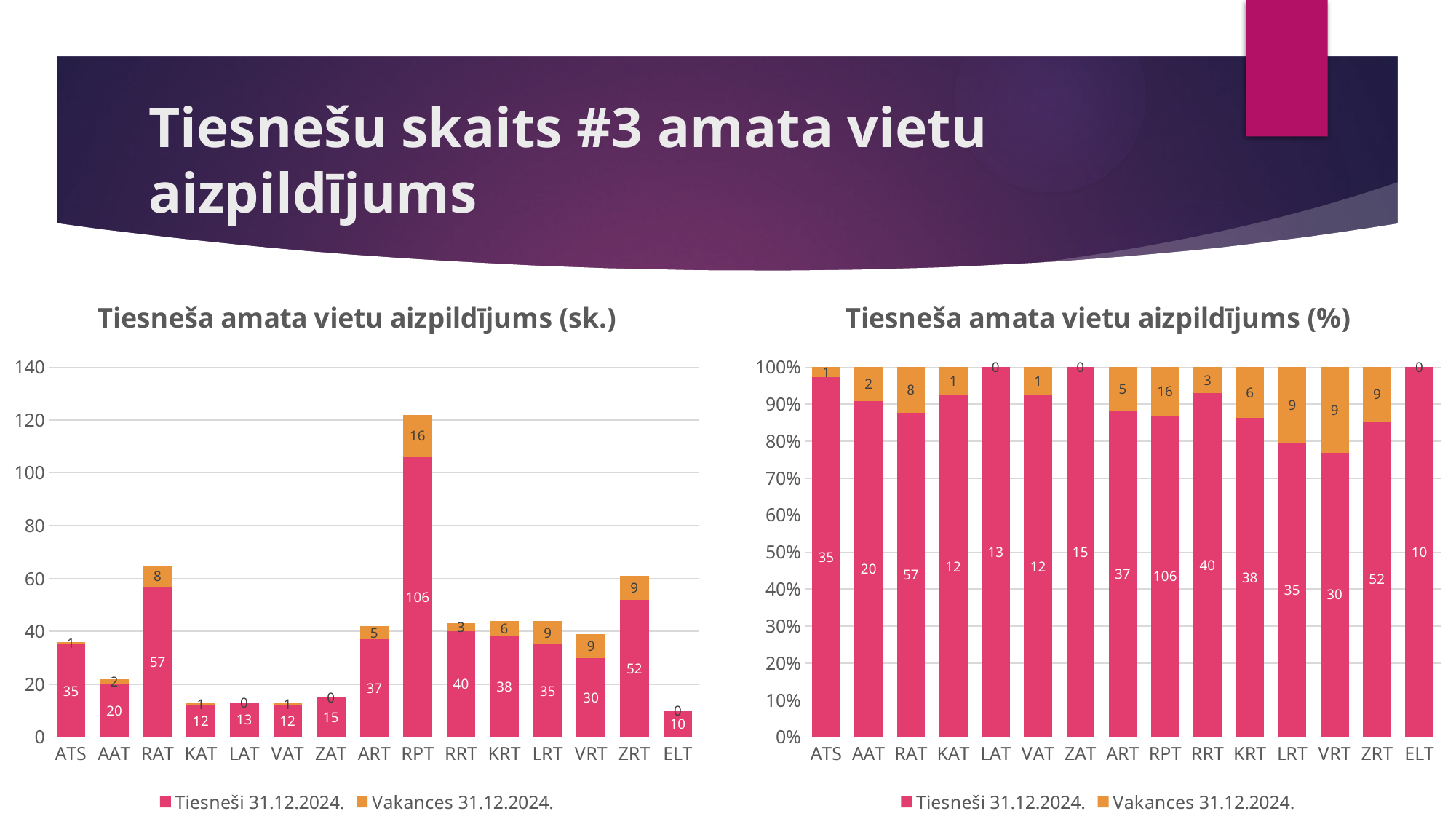
In the chart titled "Tiesneša amata vietu aizpildījums (sk.)", what is the value of Vakances 31.12.2024. for ZRT? 9 In the chart titled "Tiesneša amata vietu aizpildījums (%)", what is the Vakances 31.12.2024. value for RPT? 16 In the chart titled "Tiesneša amata vietu aizpildījums (sk.)", which category has the lowest Tiesneši 31.12.2024. value? ELT In the chart titled "Tiesneša amata vietu aizpildījums (sk.)", how many categories are shown on the x axis? 15 In the chart titled "Tiesneša amata vietu aizpildījums (sk.)", which is larger, the Tiesneši 31.12.2024. value for RRT or for KRT? RRT In the chart titled "Tiesneša amata vietu aizpildījums (sk.)", what is the total of the stacked bar for RPT? 122 In the chart titled "Tiesneša amata vietu aizpildījums (%)", how many series does the legend list? 2 In the chart titled "Tiesneša amata vietu aizpildījums (sk.)", what is the value of Tiesneši 31.12.2024. for RPT? 106 In the chart titled "Tiesneša amata vietu aizpildījums (sk.)", what colour are the Vakances 31.12.2024. bars? Orange What kind of chart is the chart titled "Tiesneša amata vietu aizpildījums (%)"? Stacked bar chart In the chart titled "Tiesneša amata vietu aizpildījums (sk.)", which category has the highest Tiesneši 31.12.2024. value? RPT In the chart titled "Tiesneša amata vietu aizpildījums (sk.)", what is the difference between the Tiesneši 31.12.2024. values for RAT and ZRT? 5